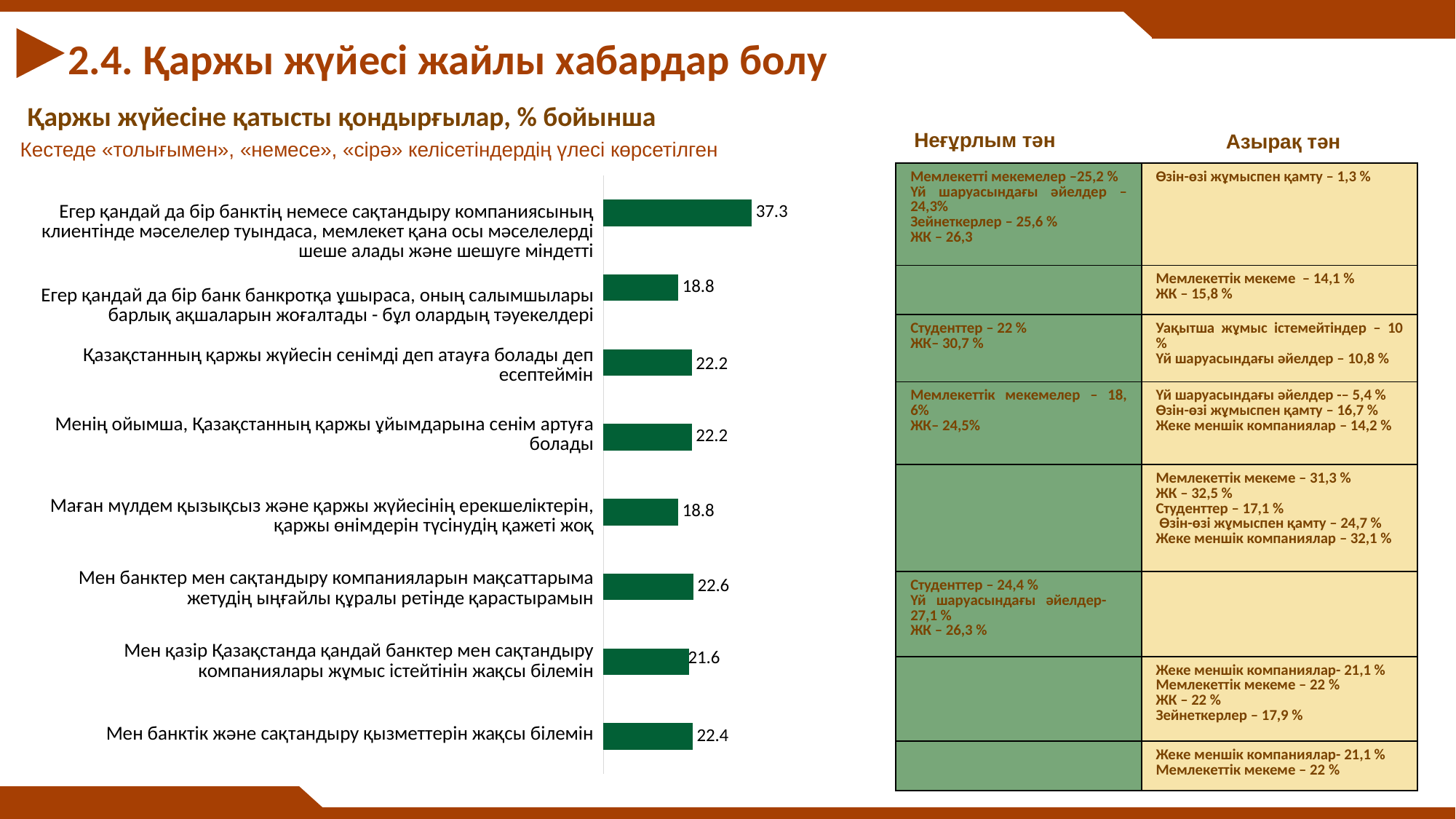
Which is larger: the value for "Мен банктер мен сақтандыру компанияларын мақсаттарыма жетудің ыңғайлы құралы ретінде қарастырамын" or for "Менің ойымша, Қазақстанның қаржы ұйымдарына сенім артуға болады"? Мен банктер мен сақтандыру компанияларын мақсаттарыма жетудің ыңғайлы құралы ретінде қарастырамын What is the difference between the highest value (37.3) and the value for "Егер қандай да бір банк банкротқа ұшыраса, оның салымшылары барлық ақшаларын жоғалтады - бұл олардың тәуекелдері"? 18.5 What is the value for "Мен қазір Қазақстанда қандай банктер мен сақтандыру компаниялары жұмыс істейтінін жақсы білемін"? 21.6 What is the title of the chart? Қаржы жүйесіне қатысты қондырғылар, % бойынша What is the value for "Қазақстанның қаржы жүйесін сенімді деп атауға болады деп есептеймін"? 22.2 What is the difference between the values for "Мен банктік және сақтандыру қызметтерін жақсы білемін" and "Мен қазір Қазақстанда қандай банктер мен сақтандыру компаниялары жұмыс істейтінін жақсы білемін"? 0.8 What colour are the bars in the chart? Dark green What is the value for "Мен банктік және сақтандыру қызметтерін жақсы білемін"? 22.4 What kind of chart is shown on the slide? Bar chart What is the lowest value shown in the chart? 18.8 How many statements (bars) are shown in the chart? 8 Which statement has the highest value in the chart? Егер қандай да бір банктің немесе сақтандыру компаниясының клиентінде мәселелер туындаса, мемлекет қана осы мәселелерді шеше алады және шешуге міндетті